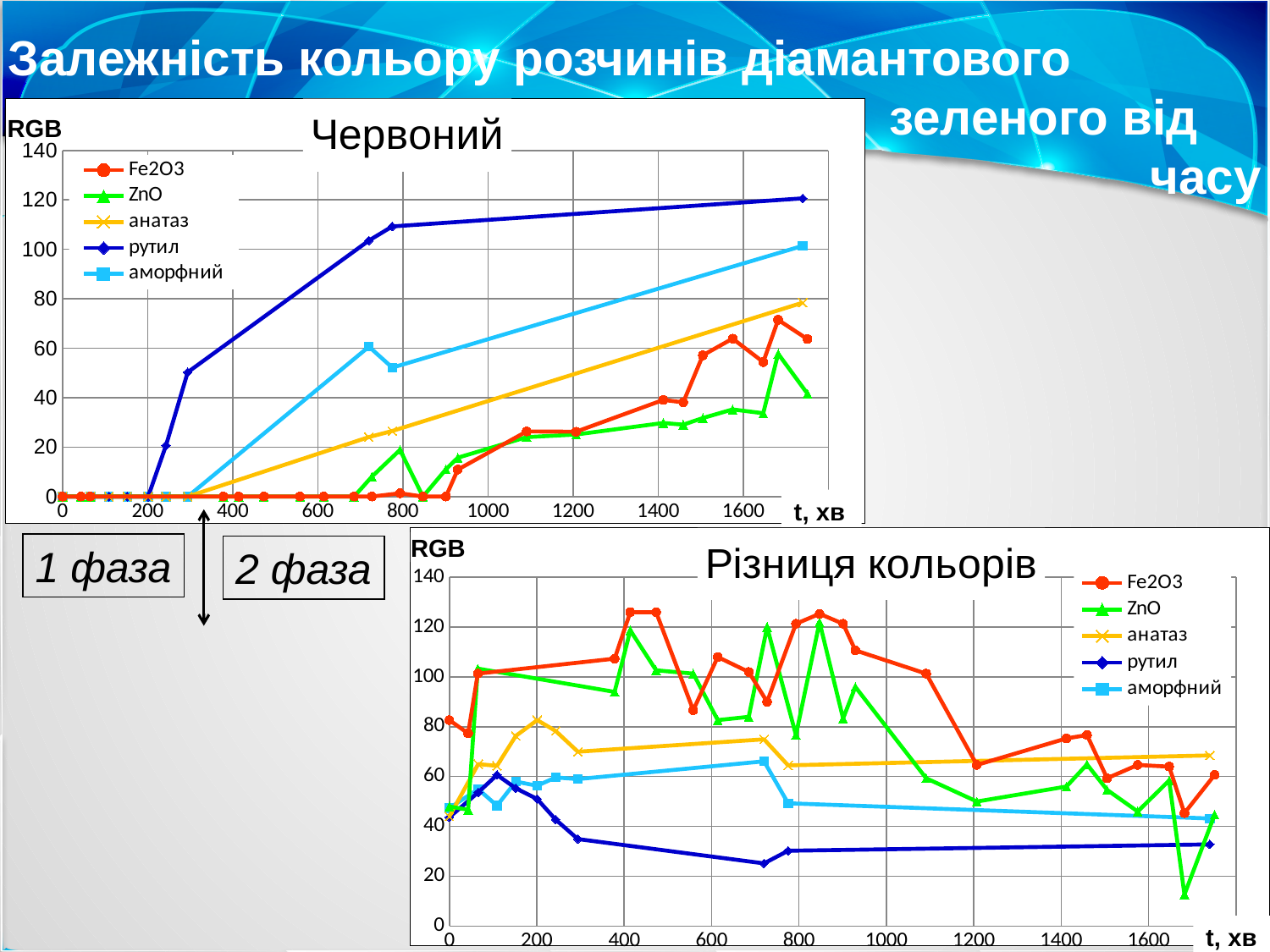
In the "Різниця кольорів" chart, is the value for рутил at about t = 700 greater or less than 40? less How many series does the legend of the "Різниця кольорів" chart list? 5 In the "Червоний" chart, is the value for рутил at about t = 1700 greater or less than 100? greater In the "Червоний" chart, does the рутил series rise or fall as t increases? rises In the "Червоний" chart, is the value for ZnO at about t = 1700 greater or less than 60? less What label is shown on the x axis of the "Різниця кольорів" chart? t, хв In the "Різниця кольорів" chart, which is larger at about t = 1200: Fe2O3 or рутил? Fe2O3 In the "Червоний" chart, which is larger at about t = 1400: Fe2O3 or аморфний? аморфний What kind of chart is the top chart titled "Червоний"? line chart In the "Червоний" chart, which series has the highest value at the right end of the x axis (around t = 1700)? рутил How many series does the legend of the "Червоний" chart list? 5